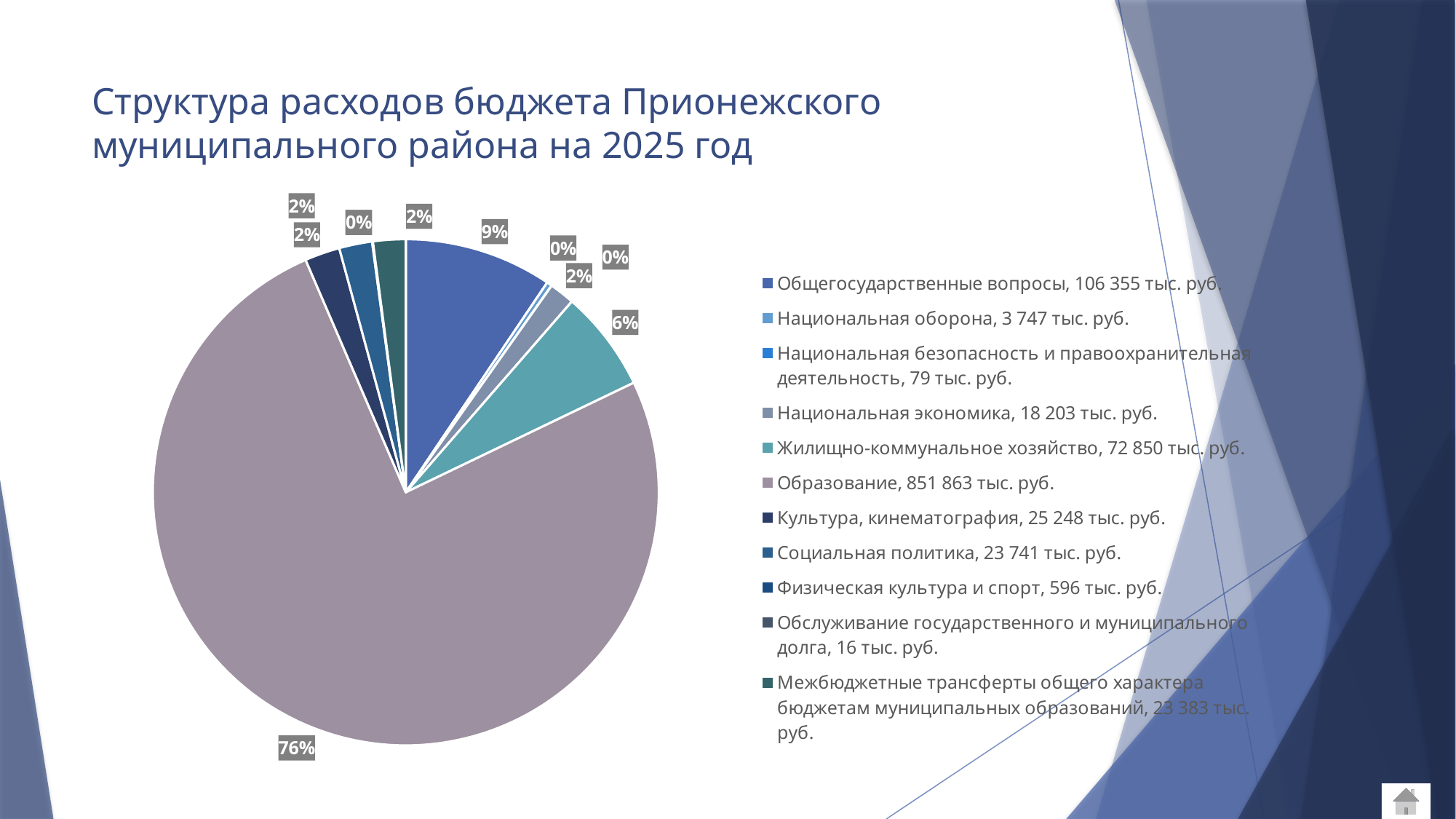
What is the title of the chart slide? Структура расходов бюджета Прионежского муниципального района на 2025 год Which category has the smallest value according to the legend? Обслуживание государственного и муниципального долга What is the value for Образование shown in the legend? 851 863 тыс. руб. What kind of chart is shown on the slide? pie chart What is the value for Национальная оборона shown in the legend? 3 747 тыс. руб. What share of the pie does Образование take? 76% What share of the pie does Жилищно-коммунальное хозяйство take? 6% What share of the pie does Общегосударственные вопросы take? 9% Which is larger: Культура, кинематография or Социальная политика? Культура, кинематография Which category has the largest slice of the pie? Образование What is the difference between Общегосударственные вопросы and Жилищно-коммунальное хозяйство? 33 505 тыс. руб. How many categories does the pie chart have? 11